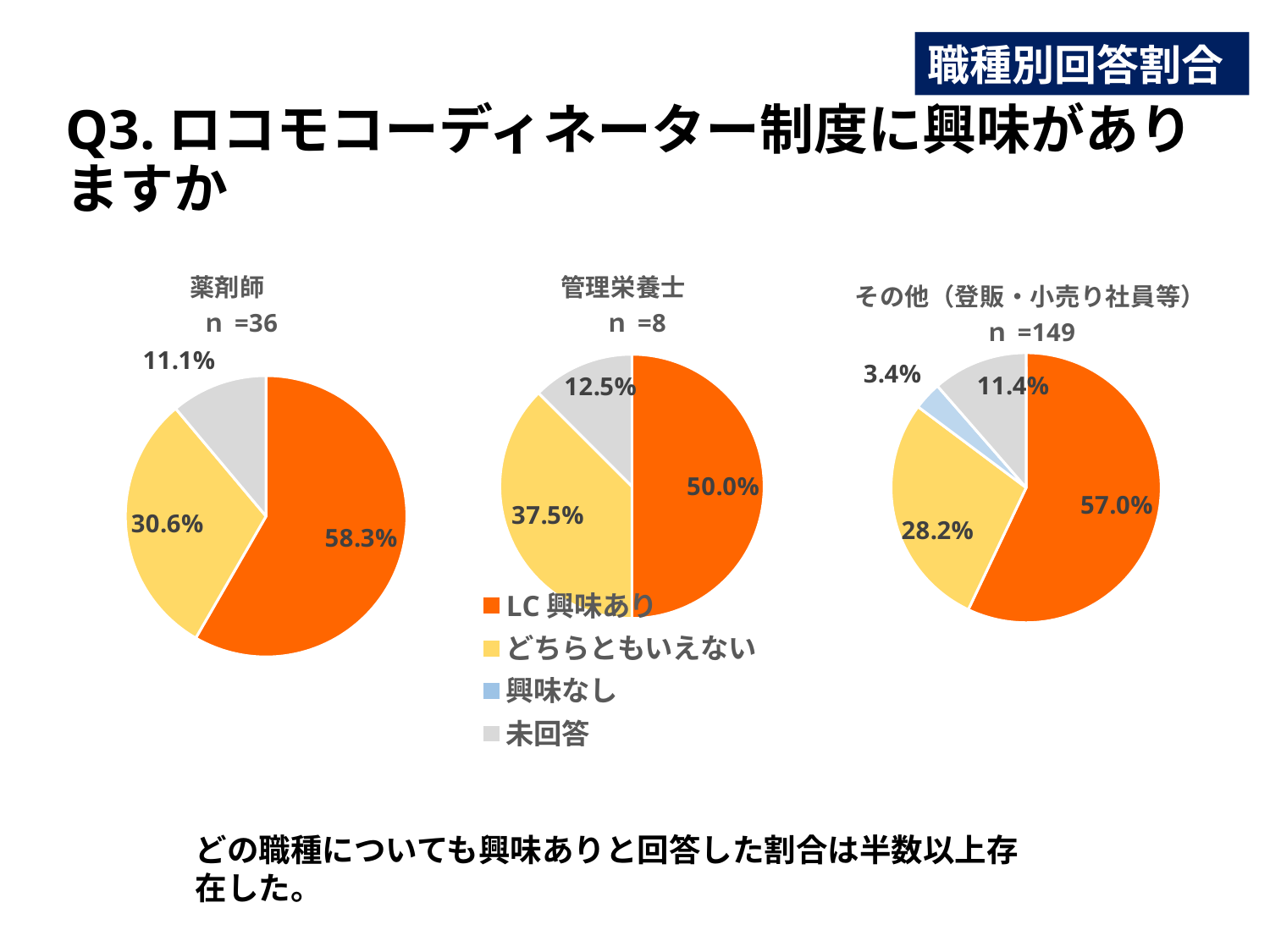
In the 管理栄養士 pie chart, what share of respondents answered どちらともいえない? 37.5% In the 薬剤師 pie chart, which response has the largest slice? LC 興味あり Which is larger: the LC 興味あり share in the 薬剤師 chart or in the その他（登販・小売り社員等） chart? 薬剤師 In the 薬剤師 pie chart, what share of respondents answered LC 興味あり? 58.3% How many slices does the その他（登販・小売り社員等） pie chart have? 4 How many entries does the legend list? 4 What kind of chart is used for the 管理栄養士 data? Pie chart In the その他（登販・小売り社員等） pie chart, what share of respondents answered 興味なし? 3.4% In the 管理栄養士 pie chart, what is the difference between the LC 興味あり share and the 未回答 share? 37.5% In the その他（登販・小売り社員等） pie chart, which response has the smallest slice? 興味なし What is the sample size (n) shown for the 管理栄養士 pie chart? 8